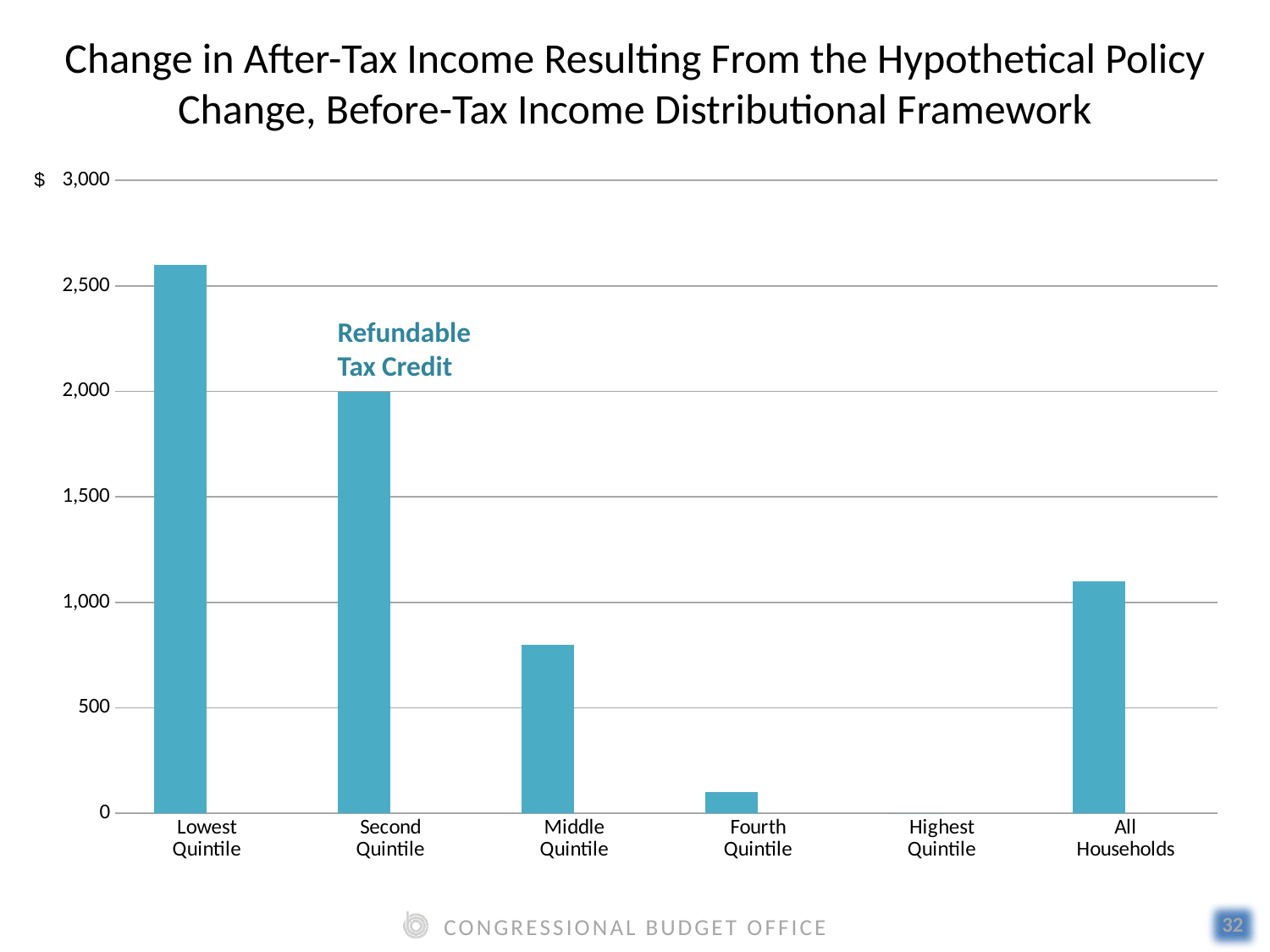
Is the value for the Lowest Quintile greater or less than 2,500? greater Which is larger, the value for the Middle Quintile or the value for All Households? All Households Is the value for the Middle Quintile greater or less than 1,000? less What is the value for the Second Quintile? 2,000 Do the values rise or fall from the Lowest Quintile to the Highest Quintile? fall What kind of chart is shown on the slide? bar chart What unit symbol is shown at the top of the vertical axis? $ Which category has the highest change in after-tax income? Lowest Quintile Which category has the lowest change in after-tax income? Highest Quintile What label is printed in blue text above the Second Quintile bar? Refundable Tax Credit Is the value for All Households greater or less than 1,000? greater How many categories are shown on the x axis? 6